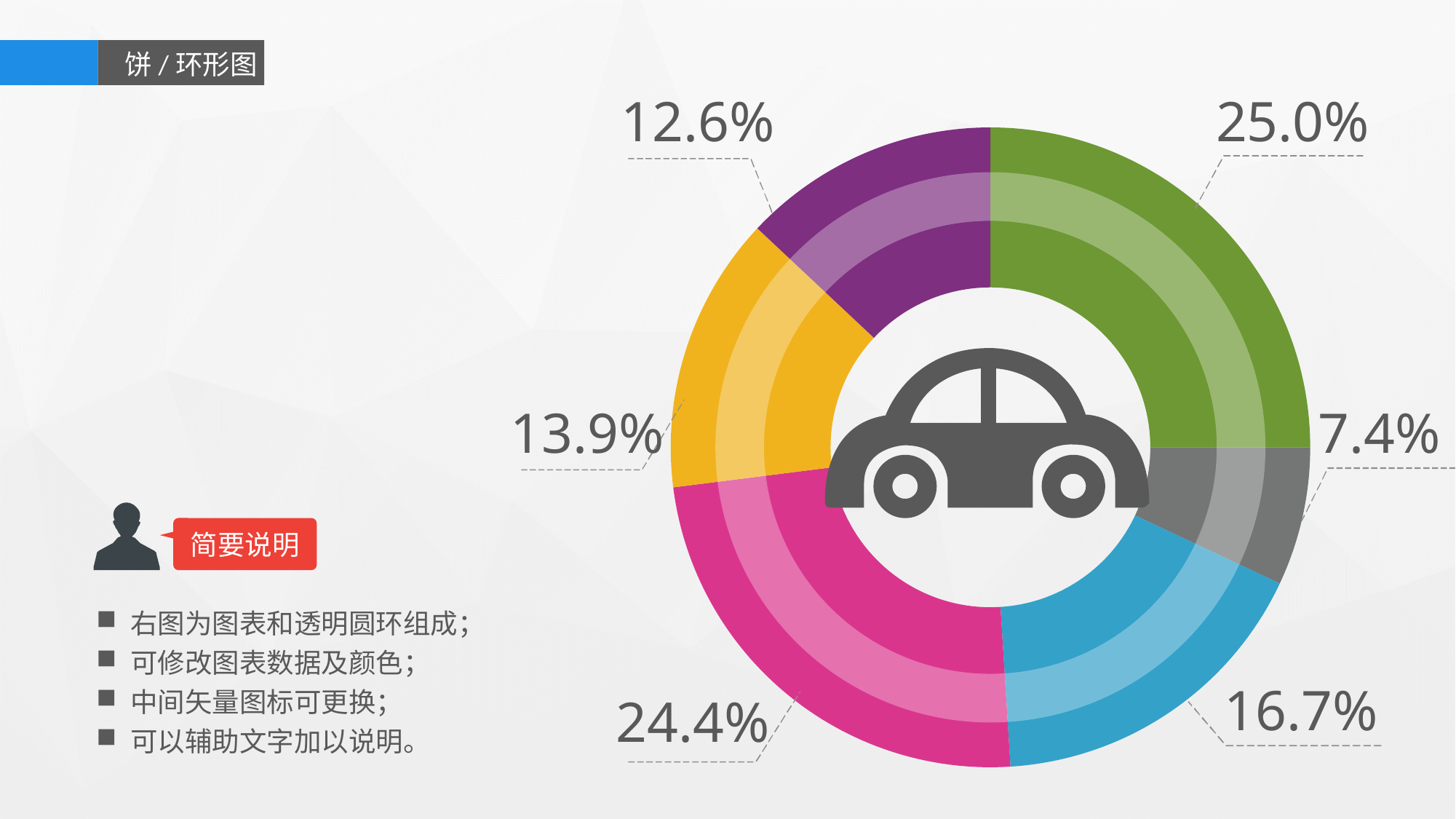
Which slice of the donut chart has the largest share? The green slice (25.0%) What percentage is shown for the blue slice of the donut chart? 16.7% What percentage is shown for the yellow slice of the donut chart? 13.9% Which is larger in the donut chart, the blue slice or the yellow slice? The blue slice (16.7%) What percentage is shown for the gray slice of the donut chart? 7.4% What is the difference between the green slice (25.0%) and the gray slice (7.4%) in the donut chart? 17.6 percentage points What percentage is shown for the magenta (pink) slice of the donut chart? 24.4% Which slice of the donut chart has the smallest share? The gray slice (7.4%) How many slices does the donut chart have? 6 What percentage is shown for the green slice of the donut chart? 25.0% What percentage is shown for the purple slice of the donut chart? 12.6% What kind of chart is shown on the slide? Donut (pie) chart